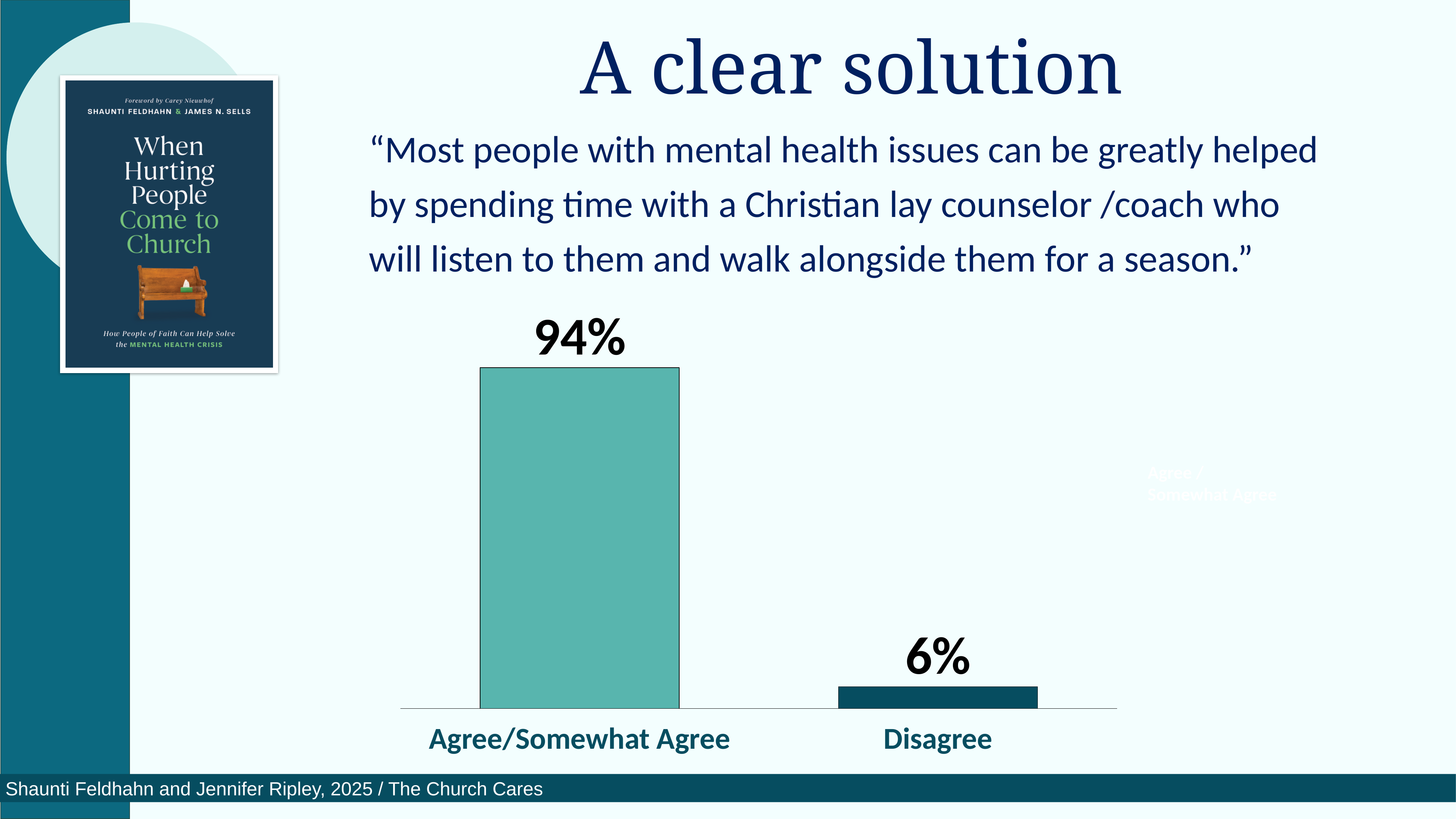
Which category has the highest value? Agree/Somewhat Agree Which category has the lowest value? Disagree What is the total of the two values shown in the chart? 100% What is the difference between the Agree/Somewhat Agree and Disagree values? 88% Which bar is drawn in the darker teal colour? Disagree What kind of chart is shown on the slide? Bar chart What is the title of the slide containing the chart? A clear solution Which is larger, the value for Agree/Somewhat Agree or the value for Disagree? Agree/Somewhat Agree How many categories are shown in the chart? 2 What percentage of respondents chose Disagree? 6% What percentage of respondents chose Agree/Somewhat Agree? 94%